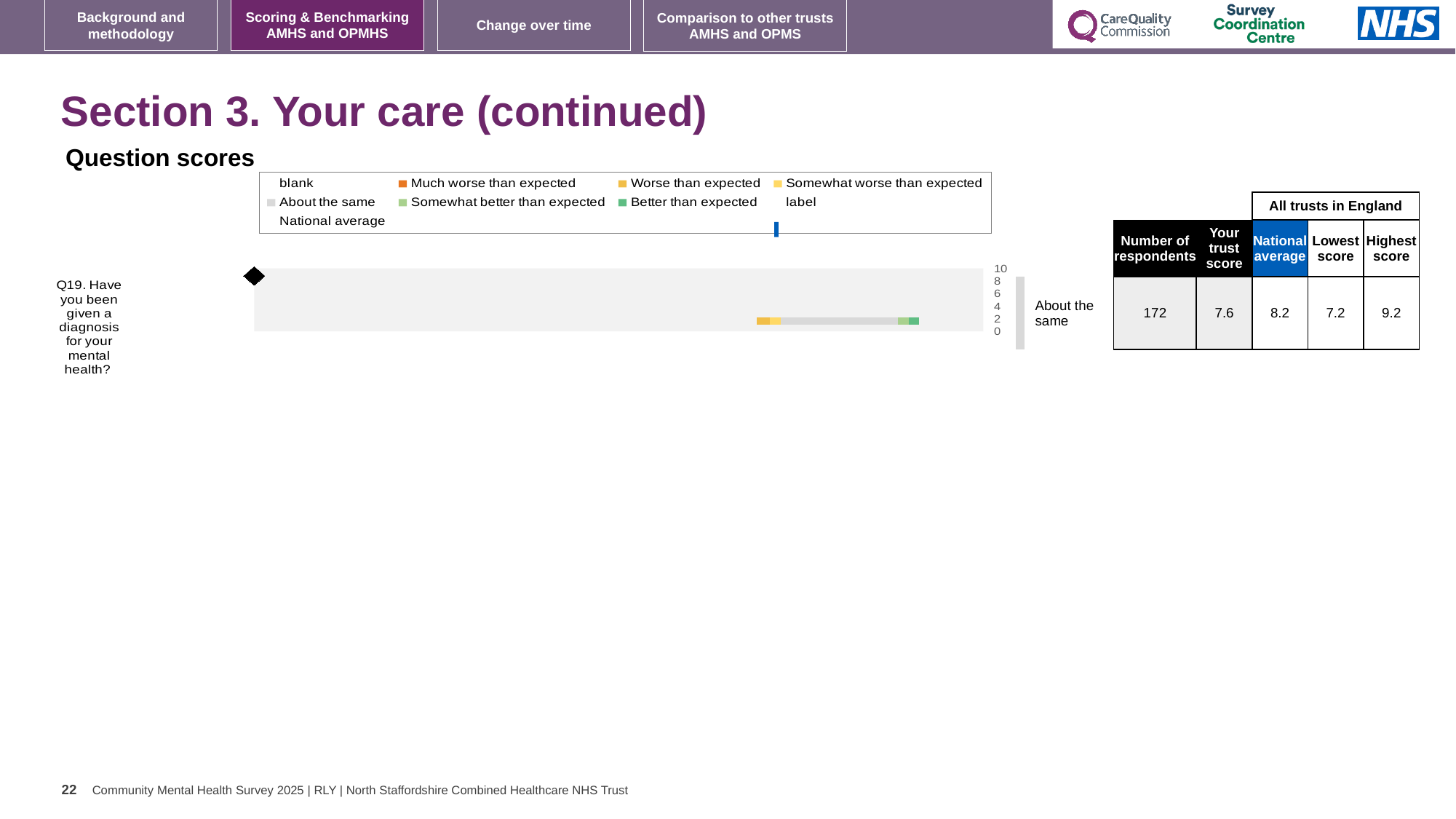
Which is larger for Q19, the trust score or the national average? national average Which question is plotted in the 'Question scores' chart? Q19. Have you been given a diagnosis for your mental health? What is the national average score for Q19? 8.2 What is the difference between the national average and the trust score for Q19? 0.6 What is the lowest score among all trusts in England for Q19? 7.2 How many survey questions are plotted in the 'Question scores' chart? 1 What is 'Your trust score' for Q19? 7.6 What is the number of respondents for Q19? 172 What kind of chart is shown under 'Question scores'? bar chart What is the highest score among all trusts in England for Q19? 9.2 What is the difference between the highest score and the lowest score for Q19? 2.0 What benchmark category is shown next to the bar for Q19? About the same